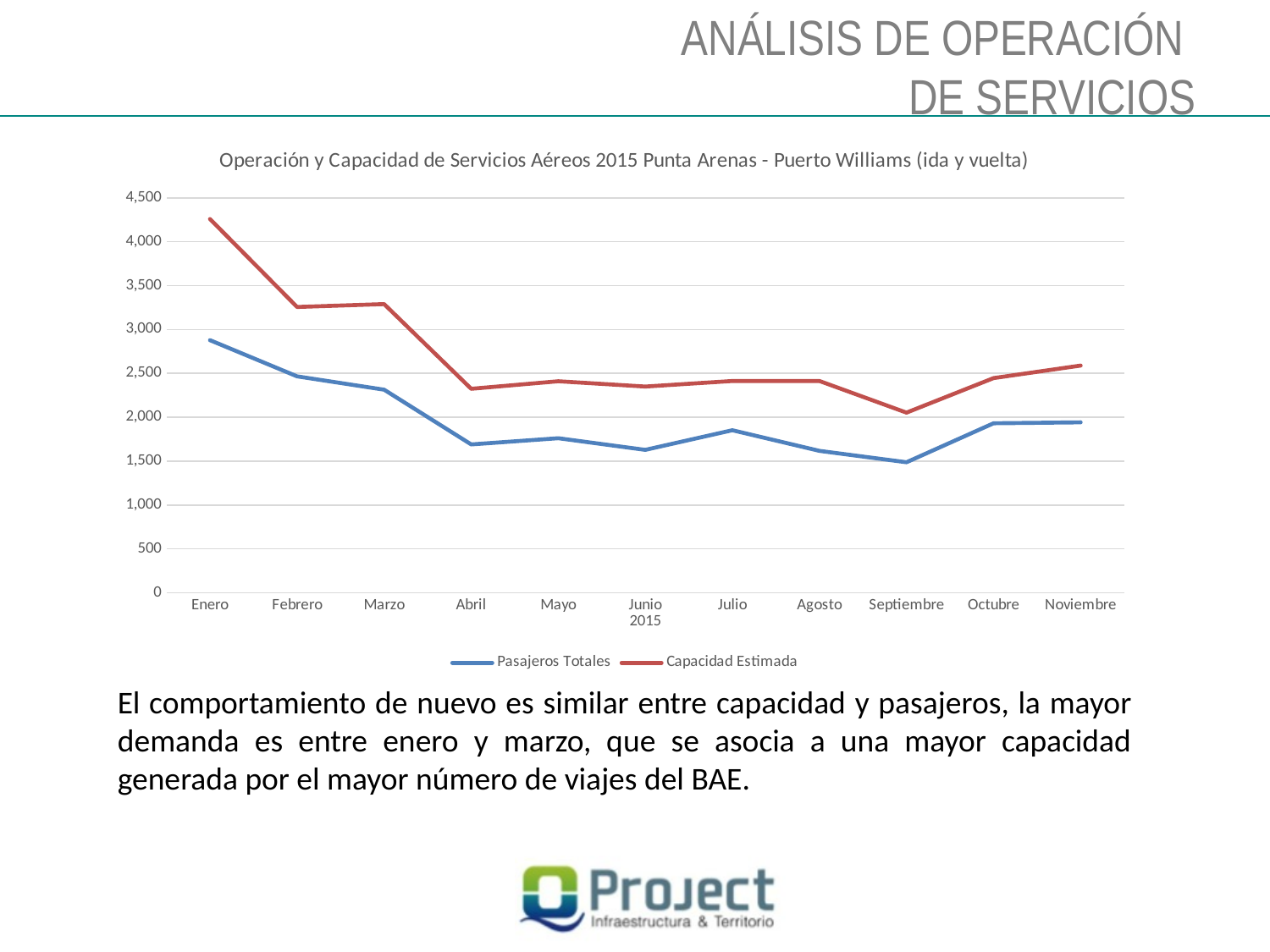
In which month is Capacidad Estimada lowest? Septiembre Does Pasajeros Totales rise or fall from Enero to Abril? Falls Which colour is used for the Capacidad Estimada line? Red In which month is Pasajeros Totales highest? Enero What kind of chart is shown on the slide? Line chart How many months are plotted along the x axis? 11 In which month is Capacidad Estimada highest? Enero Is the value of Pasajeros Totales for Abril greater or less than 2,000? less In which month is Pasajeros Totales lowest? Septiembre How many series does the legend list? 2 Is the value of Capacidad Estimada for Enero greater or less than 4,000? greater Which month has the larger Capacidad Estimada, Enero or Febrero? Enero